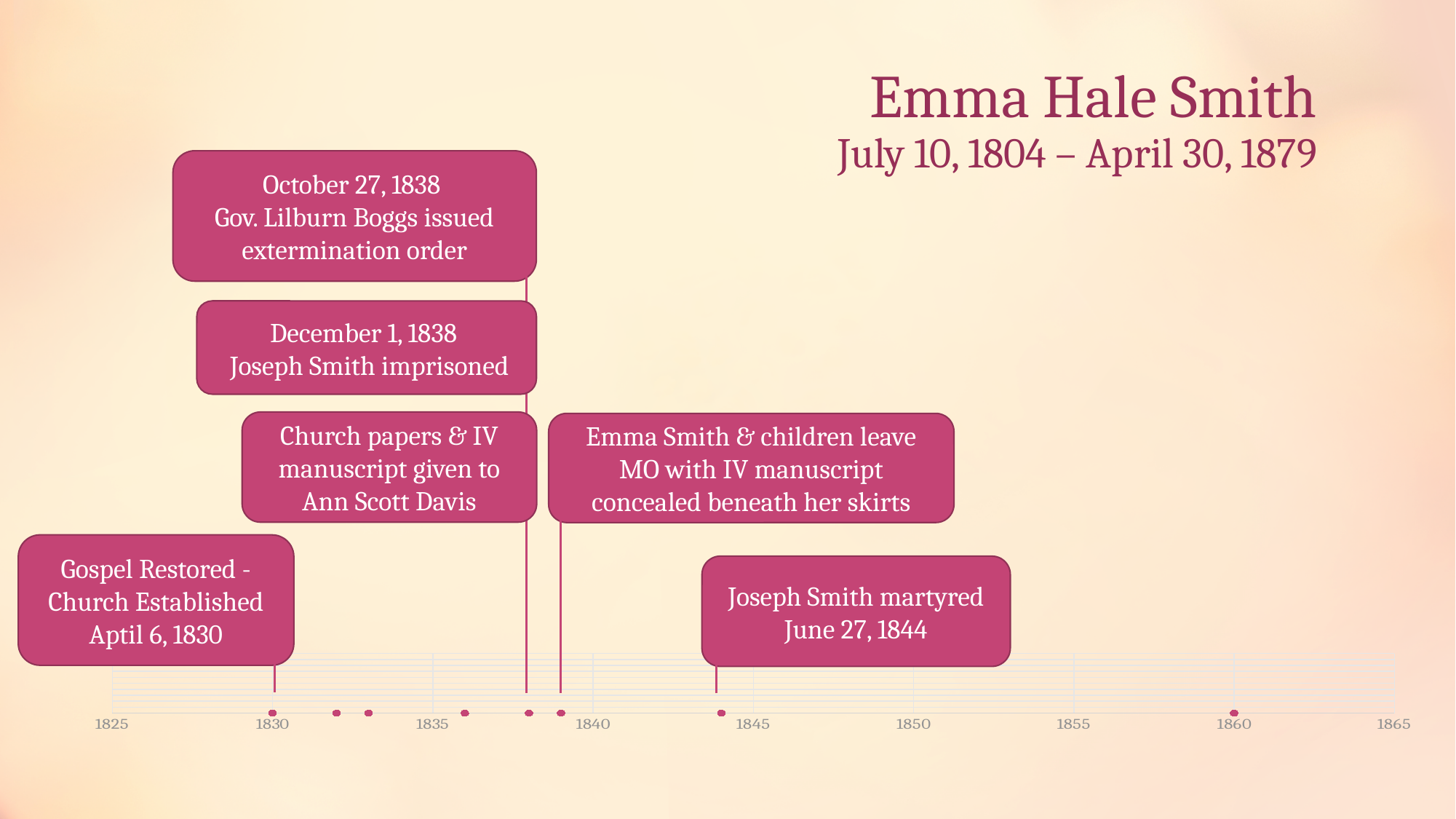
Which came first on the timeline: the extermination order or Joseph Smith being imprisoned? The extermination order How many years separate the Gospel Restored event (1830) and Joseph Smith's martyrdom (1844) on the timeline? 14 years Which labeled event on the timeline is the latest? Joseph Smith martyred On what date did Gov. Lilburn Boggs issue the extermination order according to the timeline? October 27, 1838 Which labeled event on the timeline is the earliest? Gospel Restored - Church Established How many labeled event callouts are shown on the timeline? 6 Is the event 'Emma Smith & children leave MO with IV manuscript concealed beneath her skirts' plotted before or after 1840 on the timeline? Before What is the title of the timeline? Emma Hale Smith On what date was Joseph Smith imprisoned according to the timeline? December 1, 1838 What kind of chart is shown on the slide? Timeline chart On what date was Joseph Smith martyred according to the timeline? June 27, 1844 What life dates are given under the title of the timeline? July 10, 1804 – April 30, 1879